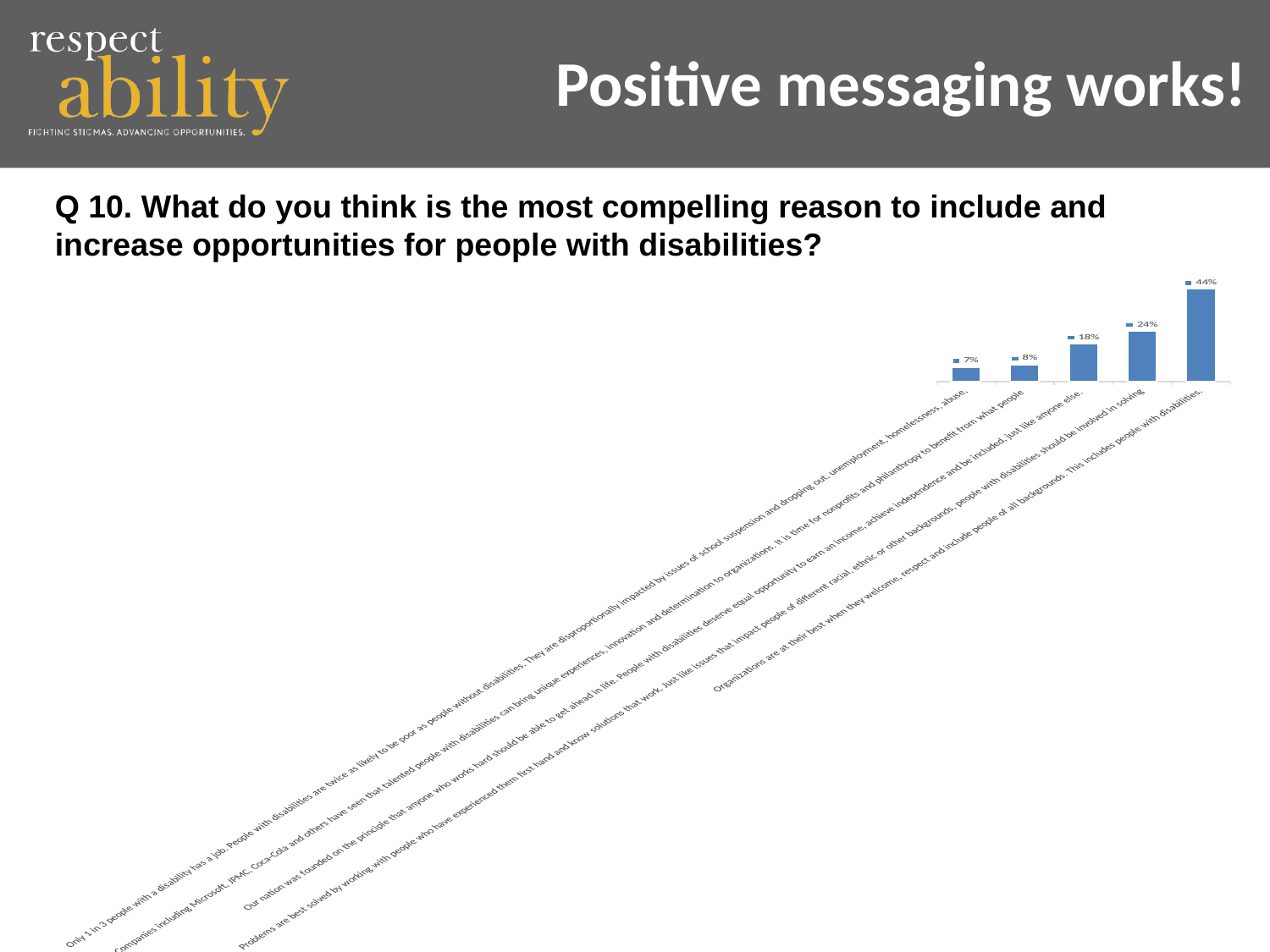
Do the bar values rise or fall from left to right across the chart? rise What is the value for the category beginning "Our nation was founded on the principle that anyone who works hard should be able to get ahead in life"? 18% What is the value of the lowest bar in the chart? 7% What is the value for the category beginning "Problems are best solved by working with people who have experienced them first hand"? 24% What is the value for the category beginning "Companies including Microsoft, JPMC, Coca-Cola and others"? 8% Which category has the lowest value in the chart? Only 1 in 3 people with a disability has a job. People with disabilities are twice as likely to be poor as people without disabilities... What is the value of the highest bar in the chart? 44% Which is larger: the value for the "Our nation was founded on the principle..." category or the value for the "Companies including Microsoft, JPMC, Coca-Cola..." category? Our nation was founded on the principle... What is the difference between the highest bar (44%) and the second-highest bar (24%)? 20% What kind of chart is shown on the slide? bar chart How many bars (categories) does the chart show? 5 Which category has the highest value in the chart? Organizations are at their best when they welcome, respect and include people of all backgrounds. This includes people with disabilities.